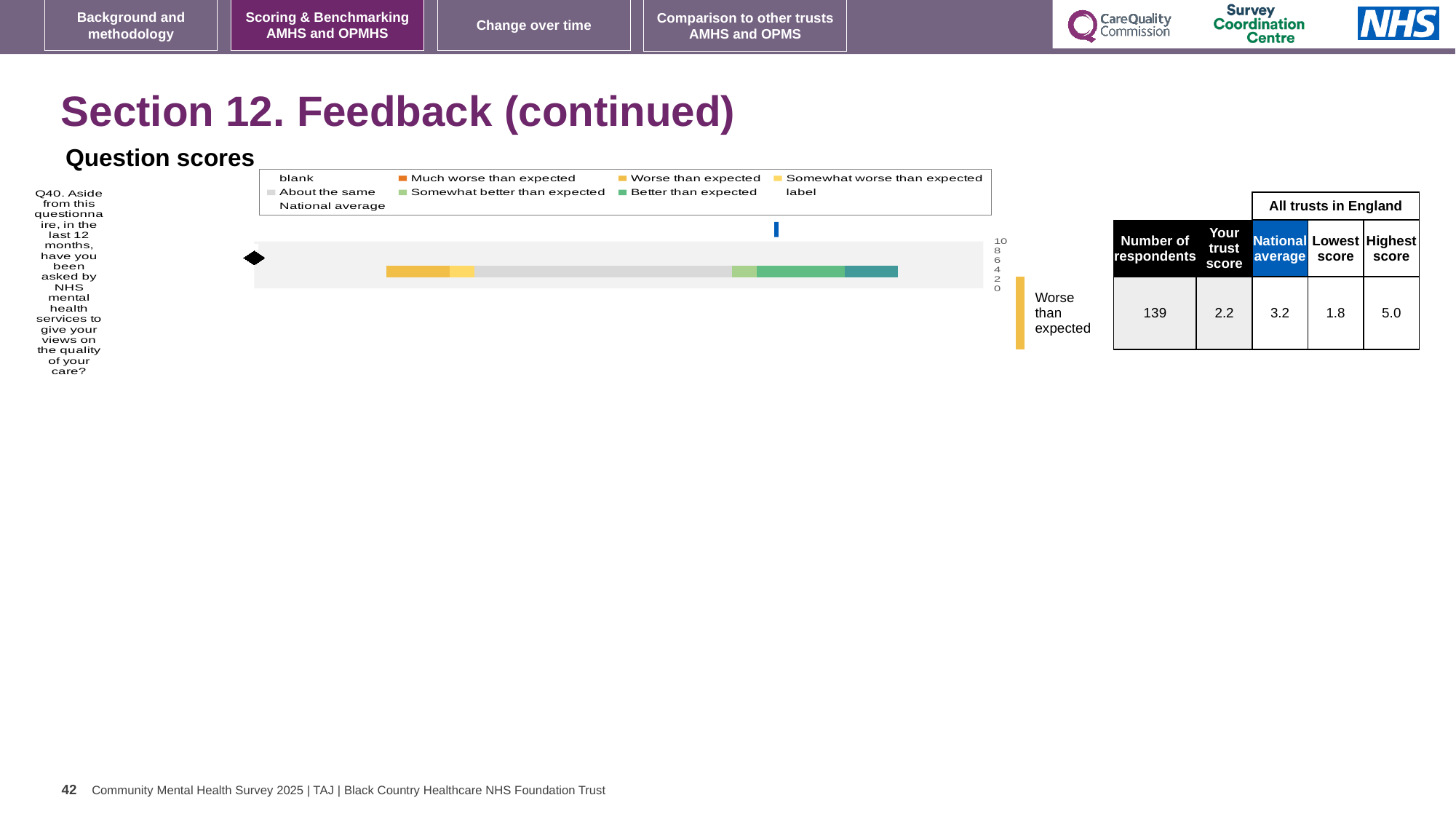
What is the trust score for Q40? 2.2 What is the lowest score among all trusts in England for Q40? 1.8 What rating label is shown to the right of the Q40 bar? Worse than expected Which is larger for Q40, the trust score or the national average? national average Which question number is plotted in the Question scores chart? Q40 What is the highest score among all trusts in England for Q40? 5.0 What is the national average score for Q40? 3.2 How many entries does the chart legend list? 9 How many respondents answered Q40? 139 How many questions are plotted in the Question scores chart? 1 What is the difference between the national average and the trust score for Q40? 1.0 What kind of chart is used to show the Q40 question score? bar chart